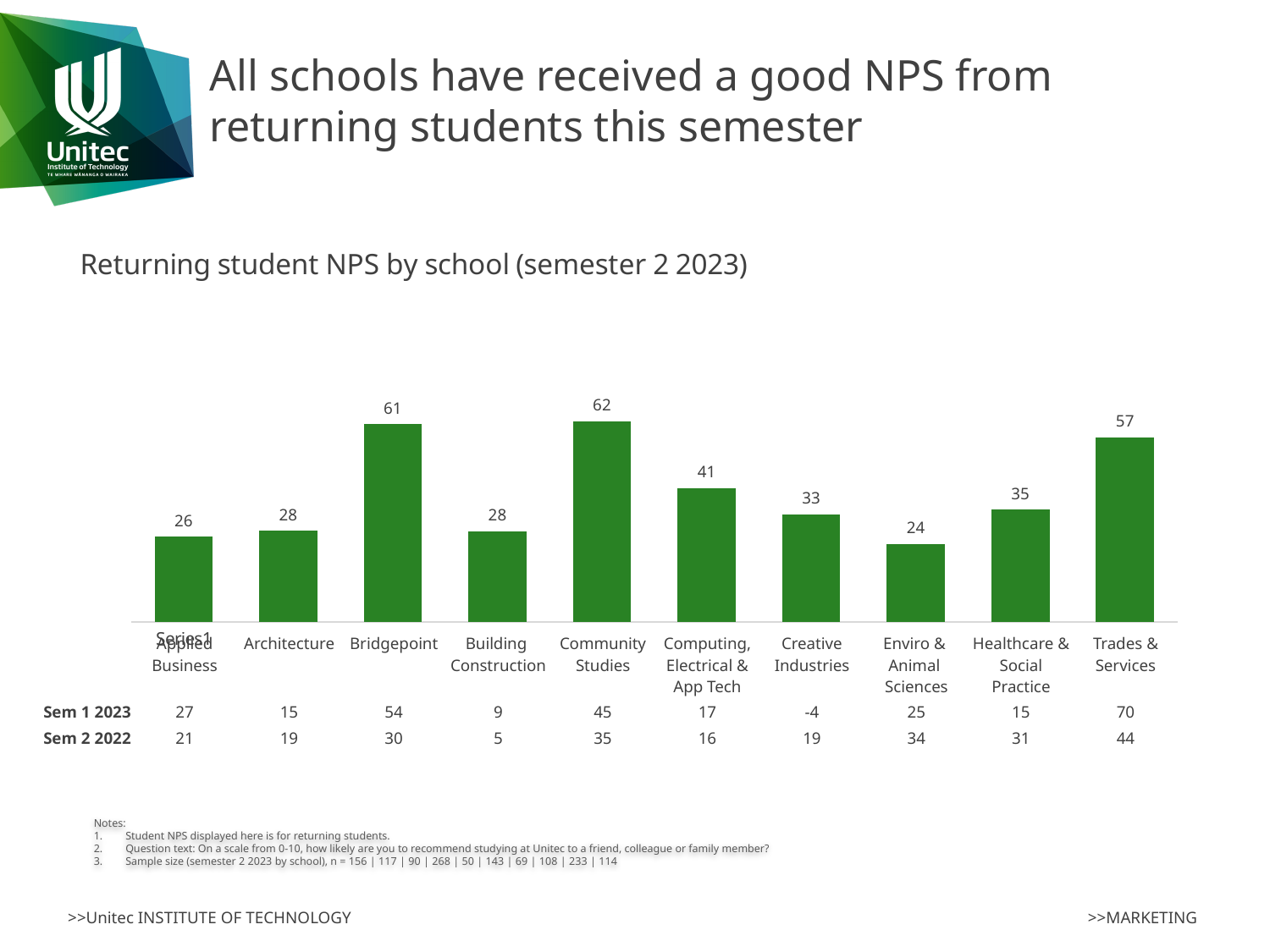
What is the returning student NPS for Bridgepoint in semester 2 2023? 61 According to the table below the chart, what was the Sem 2 2022 NPS for Trades & Services? 44 How many schools are shown in the chart? 10 What kind of chart is used to show the returning student NPS by school? Bar chart Which school has the lowest returning student NPS in semester 2 2023? Enviro & Animal Sciences According to the table below the chart, what was the Sem 1 2023 NPS for Creative Industries? -4 What is the title of the chart? Returning student NPS by school (semester 2 2023) Which school has the highest returning student NPS in semester 2 2023? Community Studies What is the difference between the semester 2 2023 NPS for Trades & Services and Applied Business? 31 Which has a higher semester 2 2023 NPS, Creative Industries or Healthcare & Social Practice? Healthcare & Social Practice What is the returning student NPS for Computing, Electrical & App Tech in semester 2 2023? 41 What is the returning student NPS for Enviro & Animal Sciences in semester 2 2023? 24